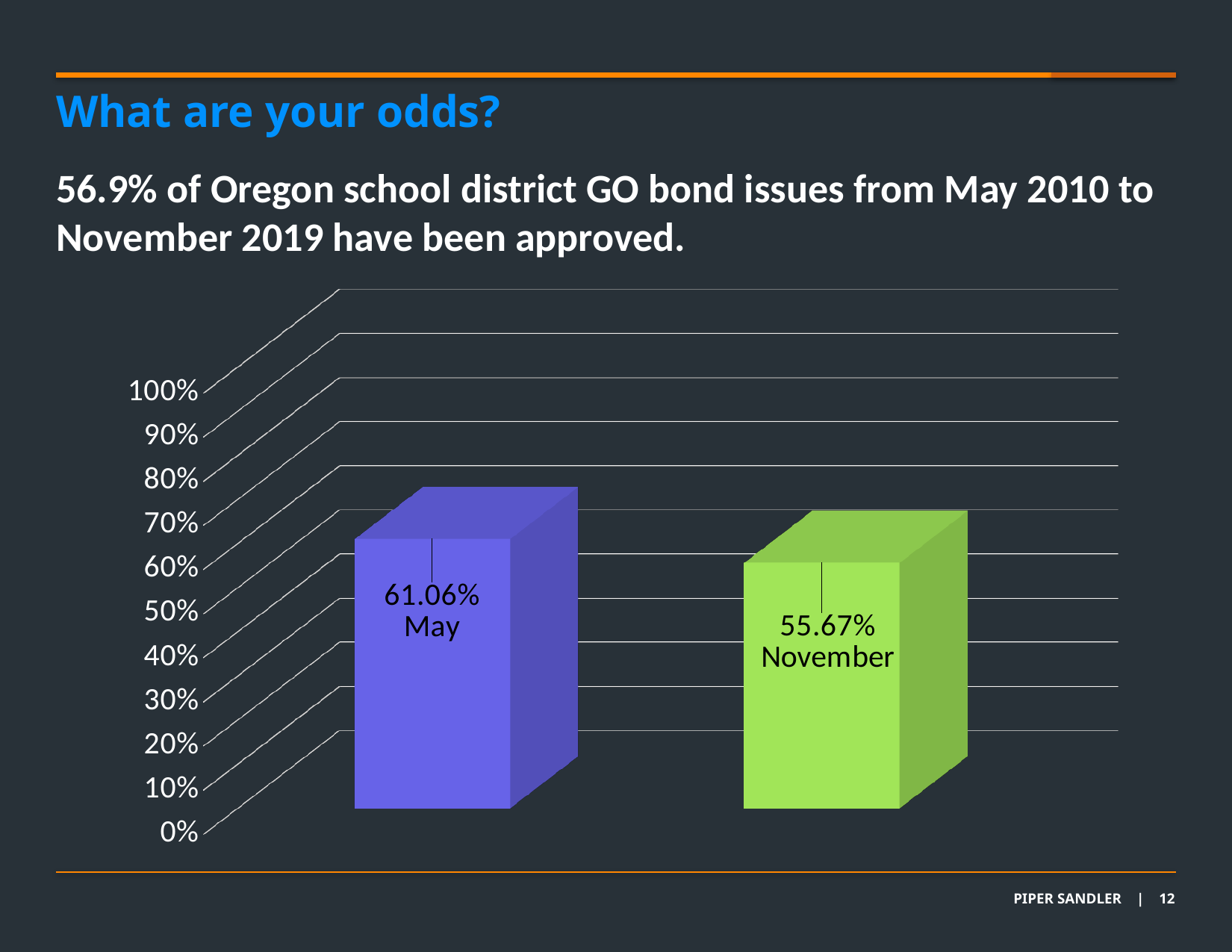
What is the difference between the May and November values? 5.39% Is the value for November greater or less than 60%? less What kind of chart is shown on the slide? bar chart What is the maximum value shown on the vertical axis? 100% How many categories are shown in the chart? 2 What is the value for November? 55.67% What is the value for May? 61.06% Which category has the lowest value? November Is the value for May greater or less than 60%? greater Which category has the highest value? May What colour is the bar for November? green Which is larger, the value for May or the value for November? May